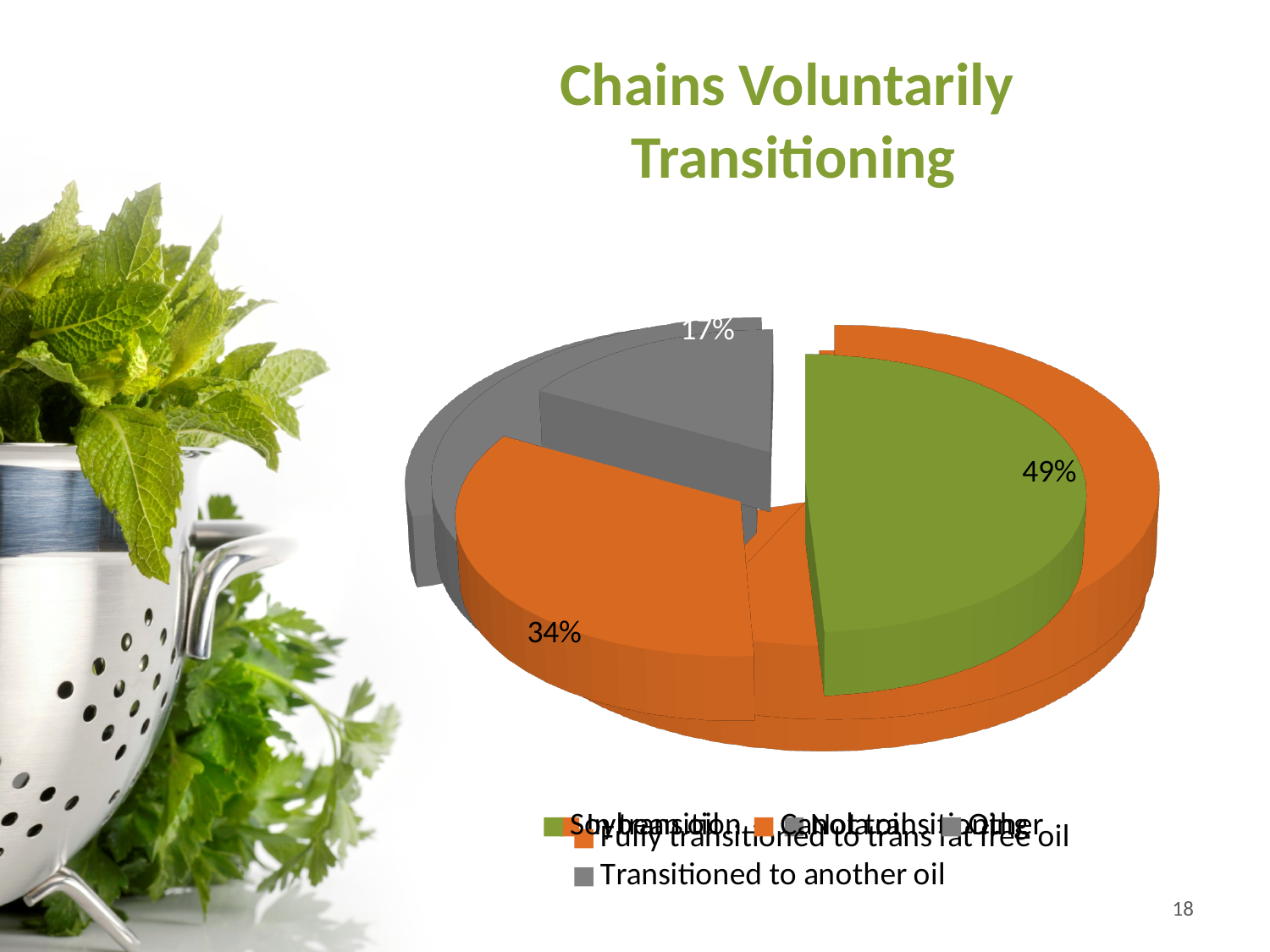
What is the difference in percentage points between the orange slice and the gray slice? 17 What is the difference in percentage points between the green slice and the orange slice? 15 Which colour slice is the largest in the pie chart? green What is the value of the smallest slice in the pie chart? 17% What is the value of the largest slice in the pie chart? 49% What kind of chart is shown on the slide? pie chart What percentage is shown on the green slice of the pie chart? 49% What is the title of the chart on the slide? Chains Voluntarily Transitioning What percentage is shown on the gray slice of the pie chart? 17% Which is larger, the orange slice or the gray slice? the orange slice What percentage is shown on the orange slice of the pie chart? 34% How many slices does the pie chart have? 3